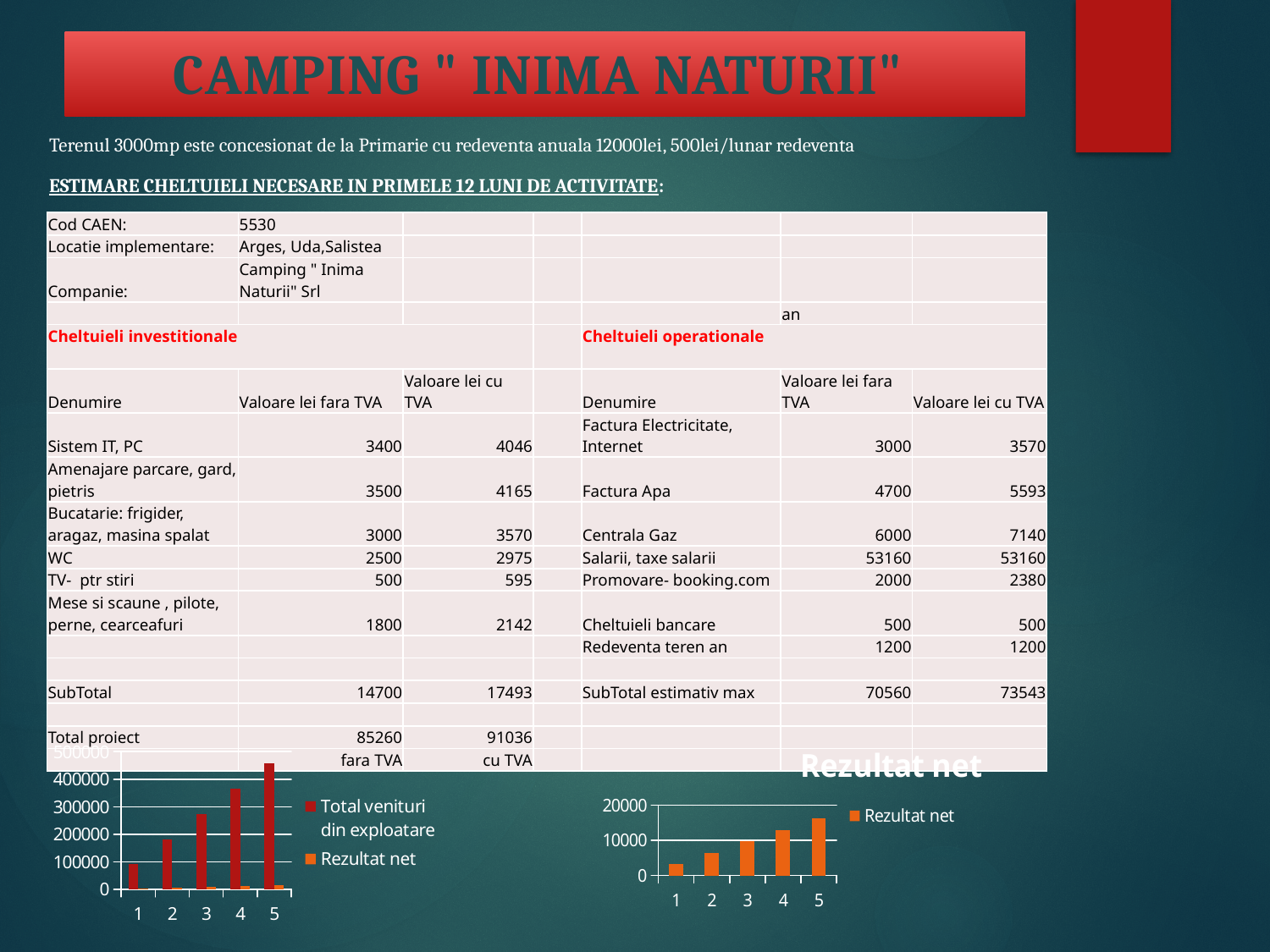
In the "Rezultat net" chart, is the value for category 5 greater or less than 10000? greater In the bottom-left chart, which series has the larger value for category 3, "Total venituri din exploatare" or "Rezultat net"? Total venituri din exploatare How many categories are shown on the x axis of the "Rezultat net" chart? 5 What is the title of the chart on the bottom right of the slide? Rezultat net What kind of chart is the "Rezultat net" chart on the bottom right? bar chart What kind of chart is the chart on the bottom left of the slide? bar chart In the bottom-left chart, which category has the highest value for "Total venituri din exploatare"? 5 In the "Rezultat net" chart, which category has the lowest value? 1 How many series does the legend of the bottom-left chart list? 2 What are the two legend entries of the bottom-left chart? Total venituri din exploatare; Rezultat net In the "Rezultat net" chart, do the values rise or fall from category 1 to category 5? rise In the bottom-left chart, is the value of "Total venituri din exploatare" for category 1 greater or less than 200000? less